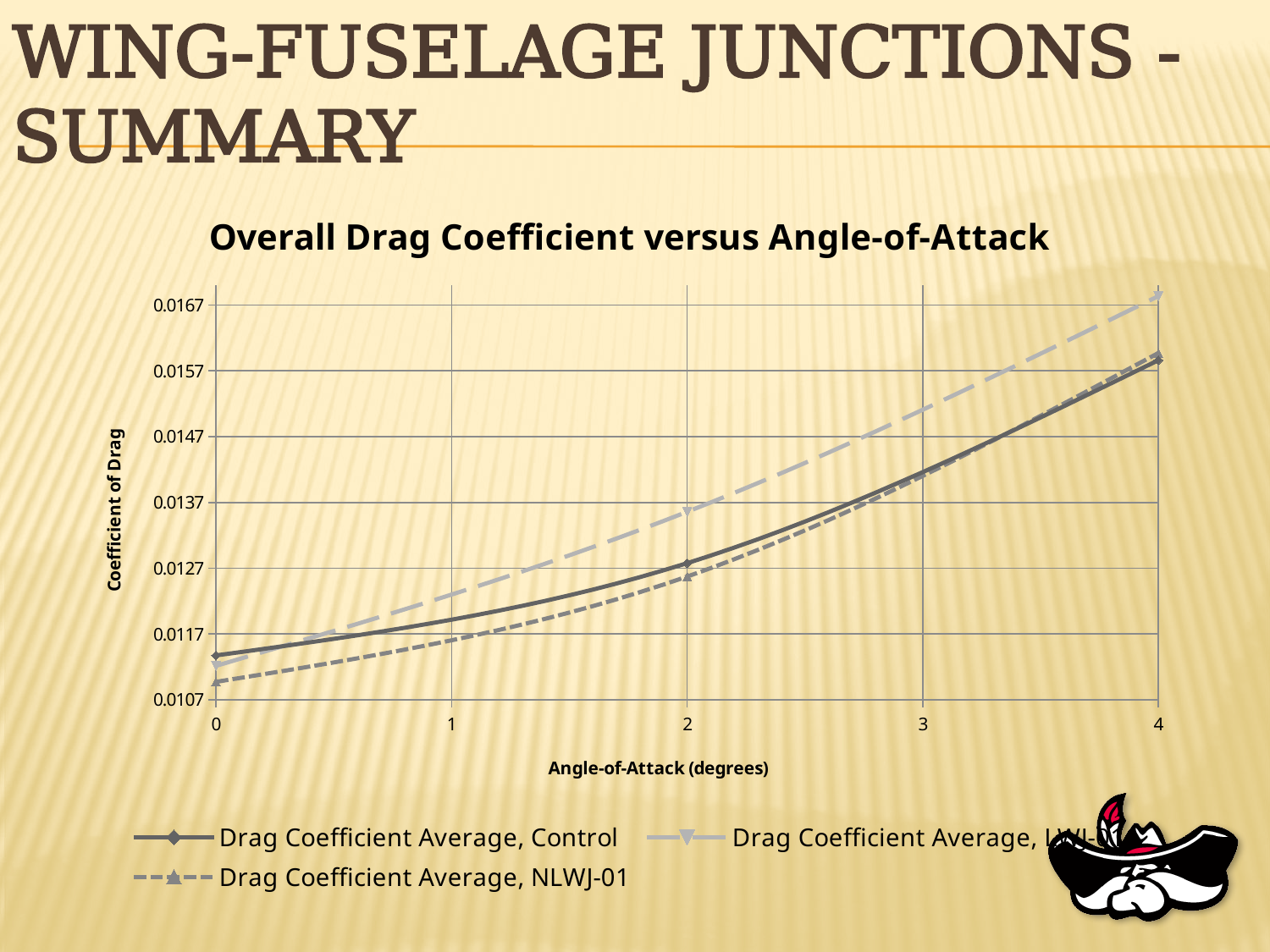
How many data points are plotted for the Drag Coefficient Average, Control series? 3 At an angle-of-attack of 2 degrees, which is larger: the Control series or the NLWJ-01 series? Control What is the title of the chart? Overall Drag Coefficient versus Angle-of-Attack Which series has the lowest coefficient of drag at an angle-of-attack of 0 degrees? Drag Coefficient Average, NLWJ-01 Is the value for the Control series at 0 degrees greater or less than 0.0117? less Which series has the highest coefficient of drag at an angle-of-attack of 4 degrees? Drag Coefficient Average, LWJ-01 Is the value for the Control series at 4 degrees greater or less than 0.0157? greater Do the values of the Drag Coefficient Average, Control series rise or fall as angle-of-attack increases? Rise What is the label of the x axis? Angle-of-Attack (degrees) How many series does the legend list? 3 Is the value for the NLWJ-01 series at 2 degrees greater or less than 0.0137? less What kind of chart is shown on the slide? Line chart